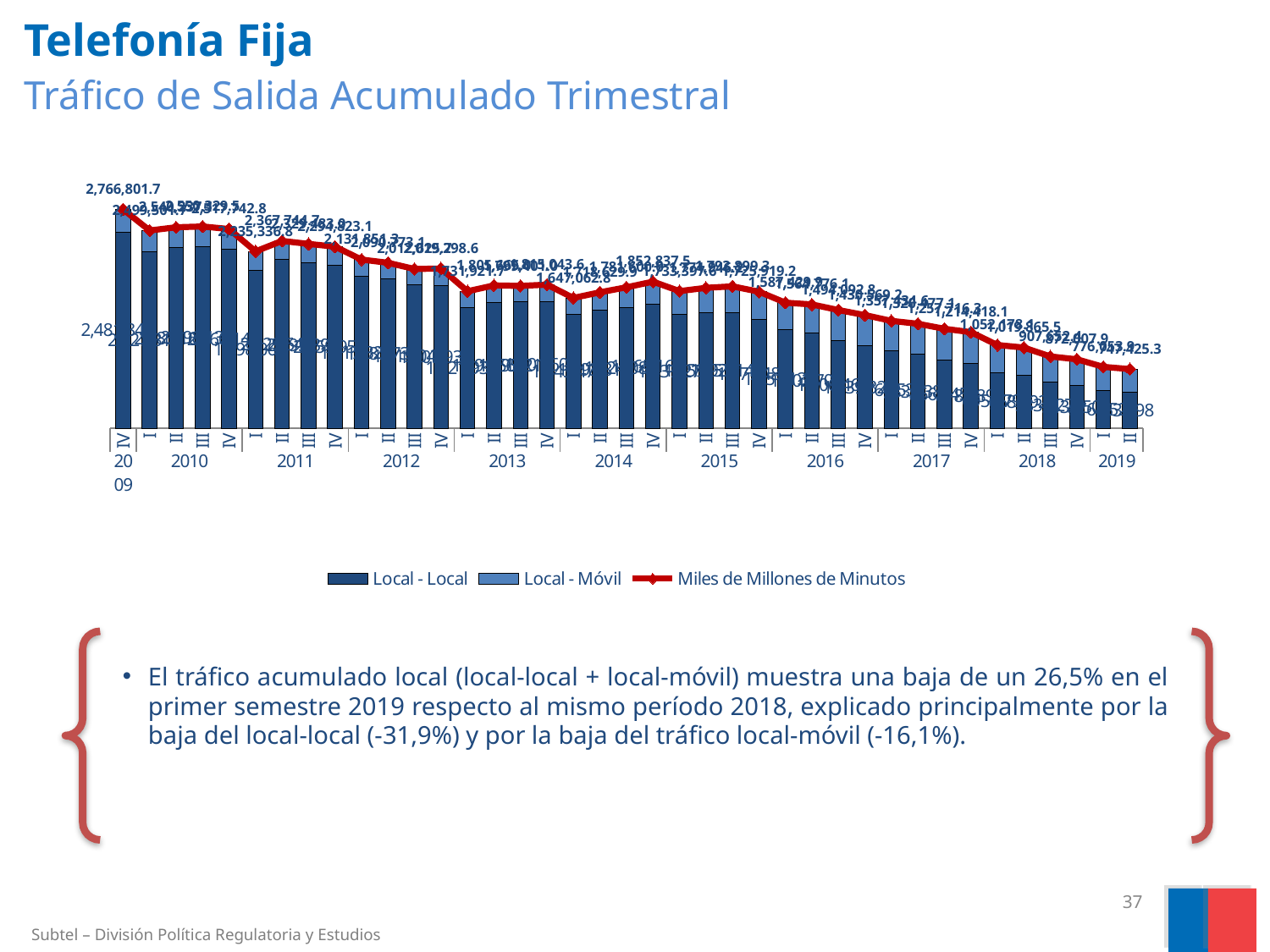
How many series does the chart legend list? 3 What is the title of the chart on the slide? Tráfico de Salida Acumulado Trimestral What is the value of the Miles de Millones de Minutos line for quarter IV of 2009? 2,766,801.7 Do the values of the Miles de Millones de Minutos line rise or fall from 2009 to 2019? Fall Which is larger, the line value for quarter IV of 2009 or for quarter II of 2019? IV 2009 What are the three series named in the chart legend? Local - Local, Local - Móvil, Miles de Millones de Minutos In which quarter does the Miles de Millones de Minutos line reach its highest value? IV 2009 In which quarter does the Miles de Millones de Minutos line reach its lowest value? II 2019 In quarter II of 2019, which segment of the stacked bar is larger, Local - Local or Local - Móvil? Local - Local How many quarterly bars are plotted on the chart? 39 What kind of chart is shown on the slide? A stacked bar chart combined with a line chart Which is the last year shown on the x axis of the chart? 2019